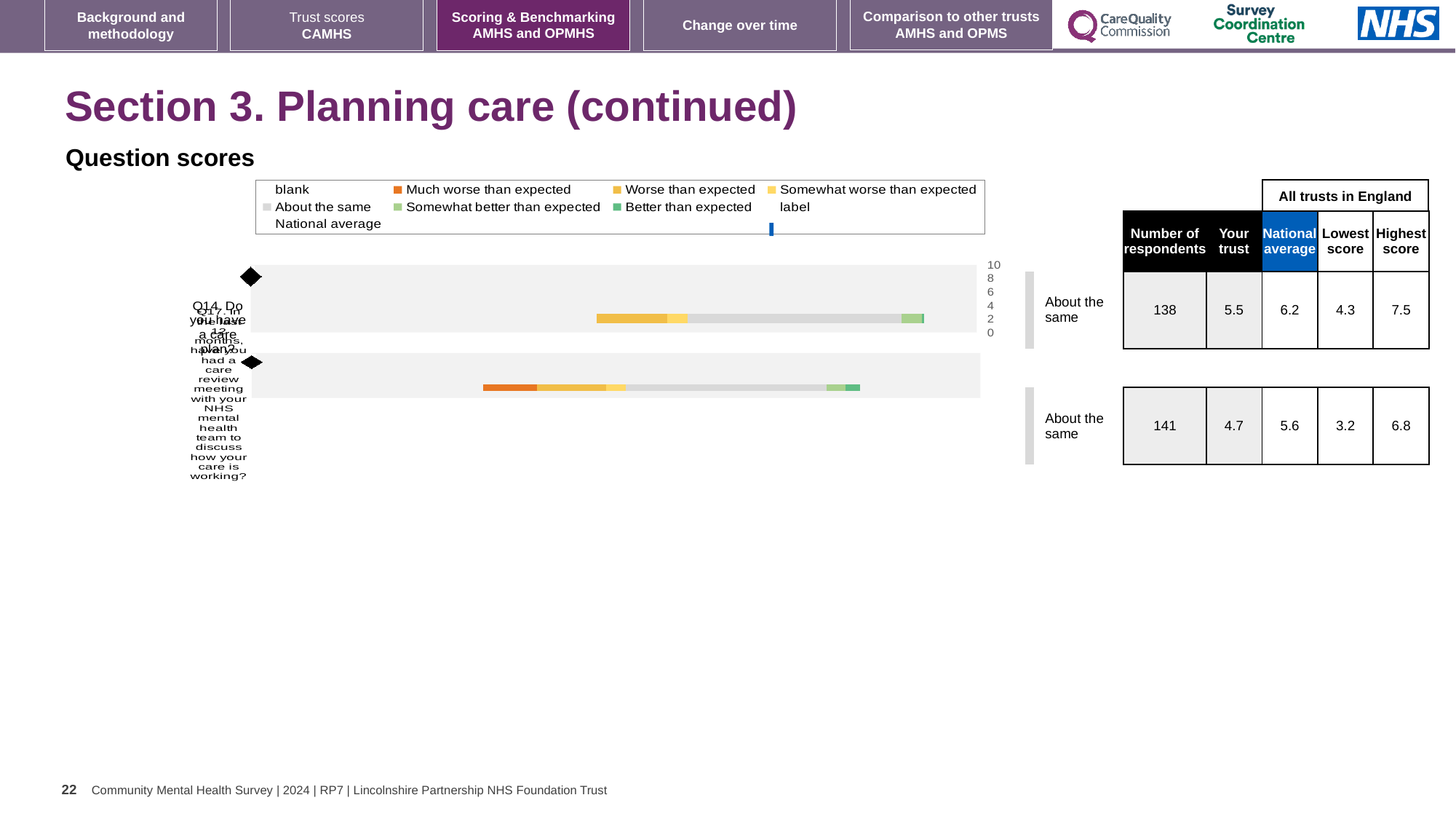
What is the difference between the highest score (7.5) and the lowest score (4.3) for Q14 in the table? 3.2 In the chart legend, what colour represents 'Much worse than expected'? orange In the table beside the chart, how many respondents answered Q17? 141 What is the difference between the national average for Q14 (6.2) and for Q17 (5.6)? 0.6 Which question has the higher 'Your trust' score in the table, Q14 or Q17? Q14 Which question has the higher 'Highest score' in the table, Q14 or Q17? Q14 In the table beside the chart, what is the 'Your trust' score for Q14 (Do you have a care plan?)? 5.5 In the table beside the chart, what is the national average score for Q17 (care review meeting)? 5.6 What benchmark category is shown next to the chart for both Q14 and Q17? About the same What kind of chart is used to show the question scores on this slide? bar chart How many questions (bars) are plotted in the question scores chart? 2